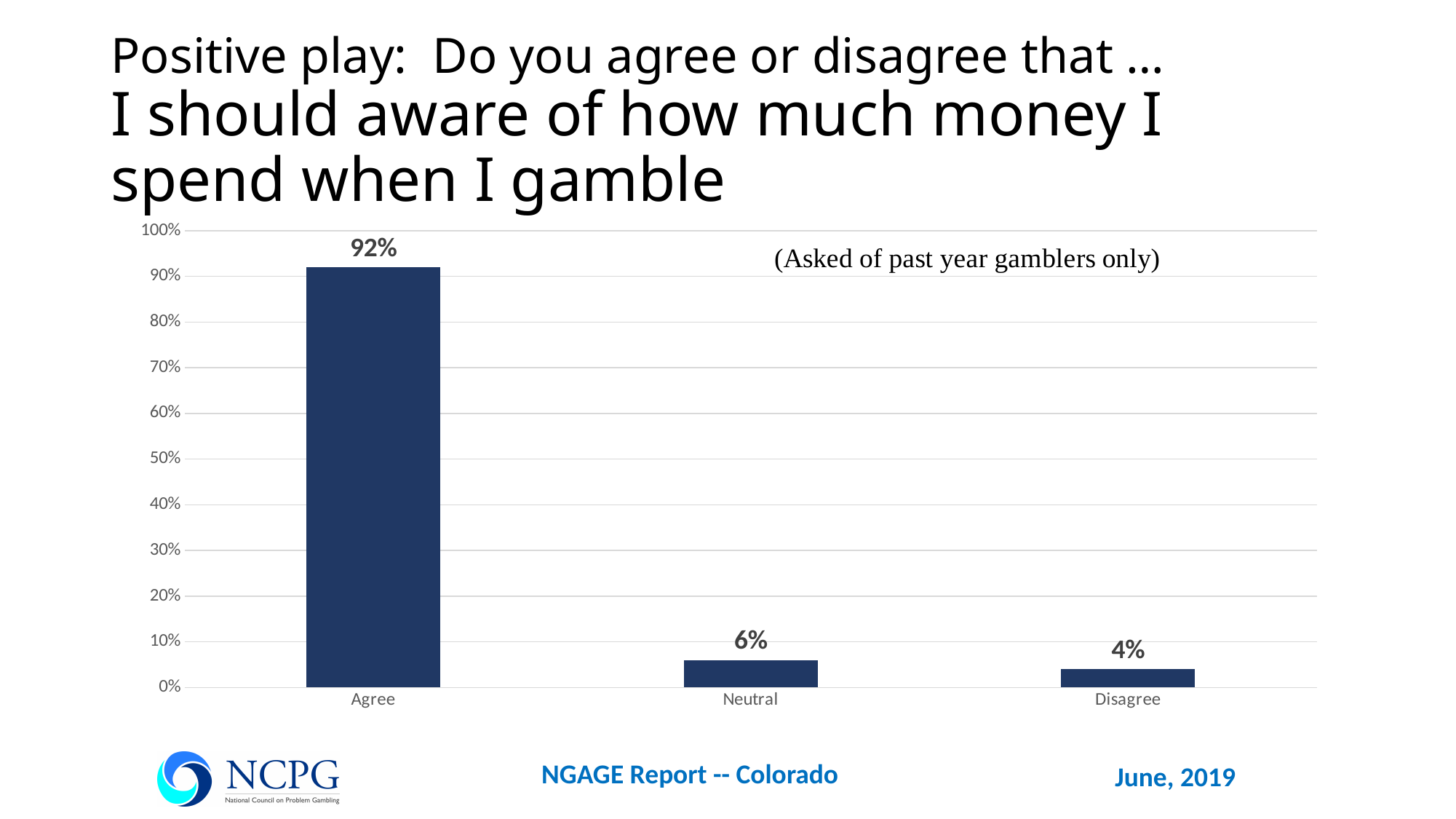
What percentage of respondents chose Agree? 92% What is the difference between the Neutral and Disagree percentages? 2% How many response categories are shown on the x axis? 3 What percentage of respondents chose Neutral? 6% What is the difference between the Agree and Disagree percentages? 88% Is the value for Agree greater or less than 90%? greater Which response category has the highest value? Agree According to the note on the chart, which respondents were asked this question? Past year gamblers only What percentage of respondents chose Disagree? 4% What kind of chart is shown on the slide? Bar chart Which is larger, the value for Neutral or the value for Disagree? Neutral Which response category has the lowest value? Disagree